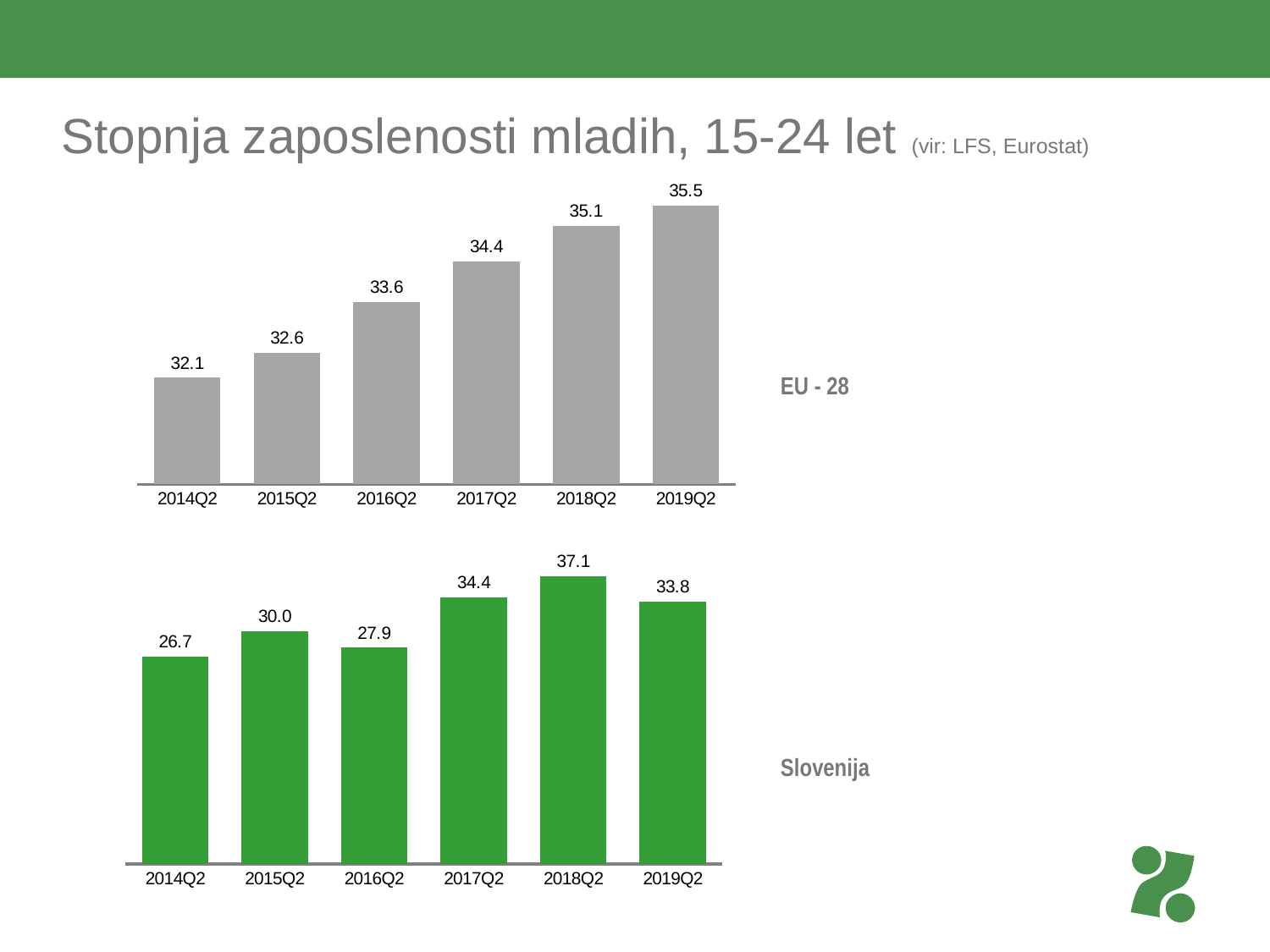
In the Slovenija chart, what is the difference between the 2018Q2 and 2019Q2 values? 3.3 In the EU - 28 chart, what is the value for 2014Q2? 32.1 In the Slovenija chart, what is the value for 2018Q2? 37.1 What kind of chart is the Slovenija chart? bar chart In the Slovenija chart, which quarter has the lowest value? 2014Q2 In the EU - 28 chart, which quarter has the lowest value? 2014Q2 What colour are the bars in the Slovenija chart? green In the EU - 28 chart, do the values rise or fall from 2014Q2 to 2019Q2? rise In the Slovenija chart, which is larger, the value for 2015Q2 or 2016Q2? 2015Q2 In the Slovenija chart, which quarter has the highest value? 2018Q2 In the EU - 28 chart, what is the difference between the 2019Q2 and 2014Q2 values? 3.4 How many quarters are shown in the EU - 28 chart? 6